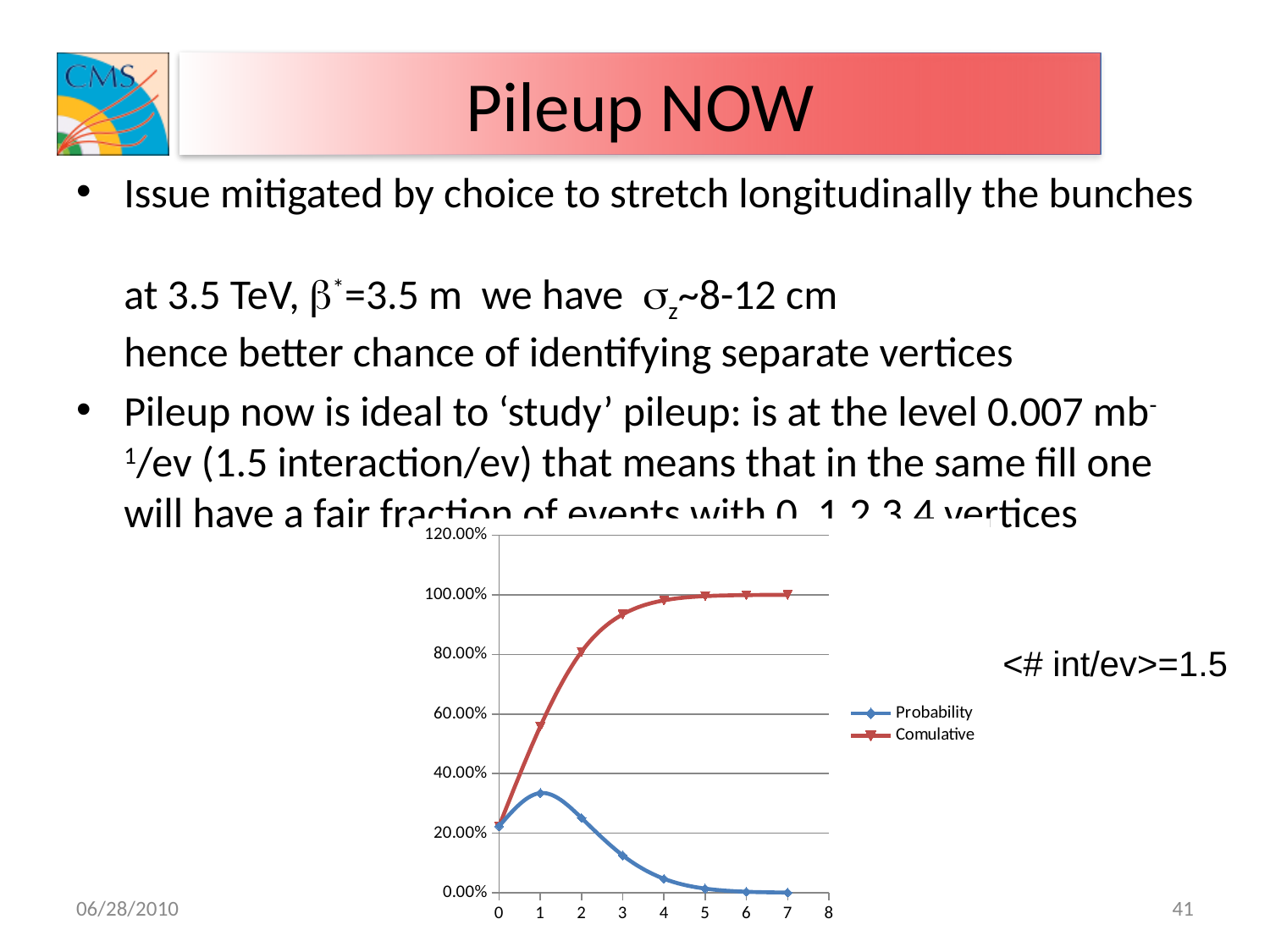
Is the Comulative value at x = 3 greater or less than 80%? greater Is the Comulative value at x = 1 greater or less than 40%? greater What colour is the Comulative line? red Does the Comulative series rise or fall as x increases from 0 to 7? rise Is the Probability value at x = 1 greater or less than 40%? less How many series does the chart's legend list? 2 At which x value does the Probability series reach its highest point? 1 How many data points does the Probability series have? 8 What kind of chart is shown on the slide? line chart What are the two series named in the legend? Probability and Comulative At x = 2, which series has the higher value, Probability or Comulative? Comulative